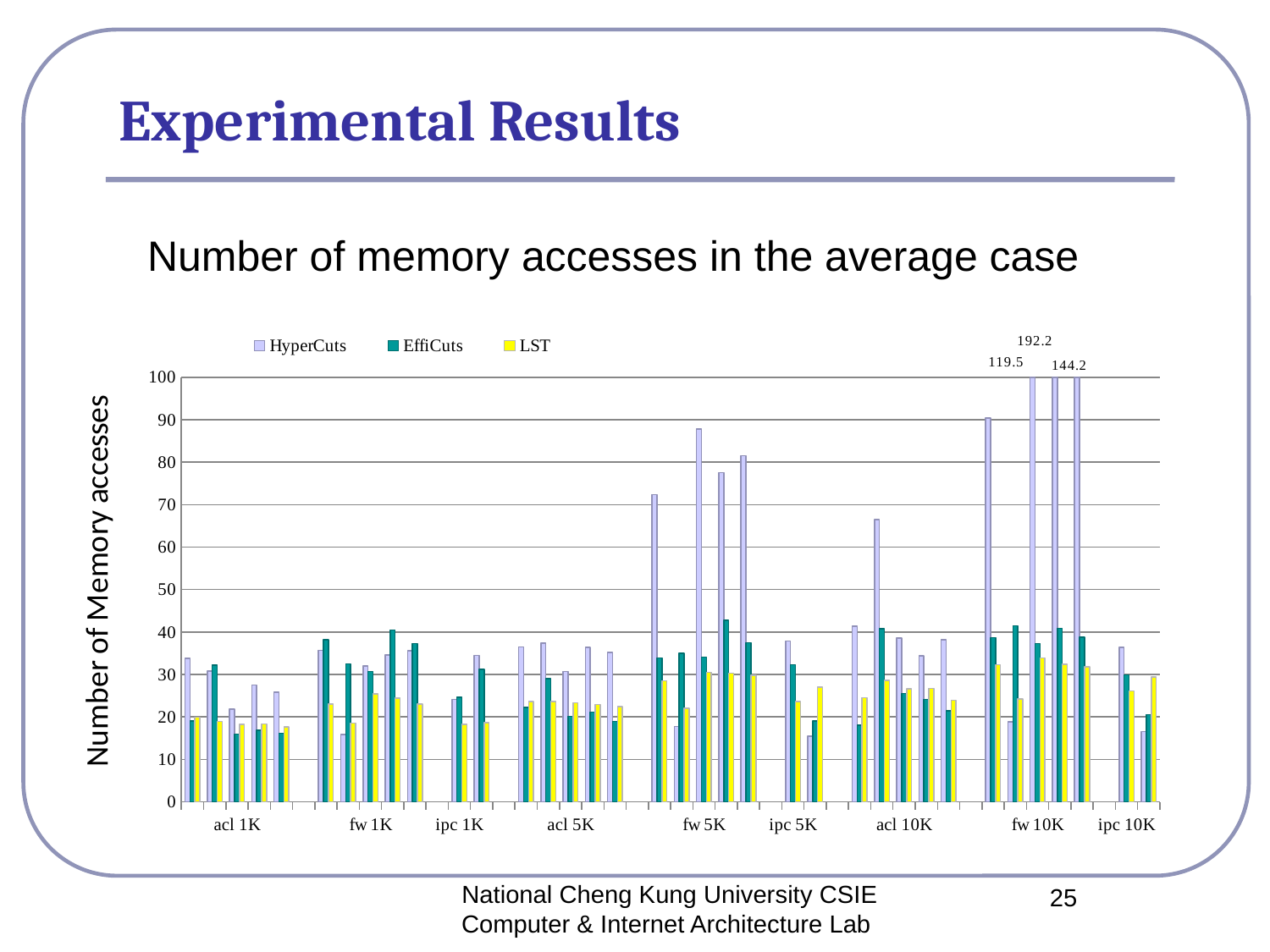
What is the largest value printed as a data label on the chart? 192.2 Which category contains the HyperCuts bars that go above the top of the y axis (100)? fw 10K Which series are listed in the legend? HyperCuts, EffiCuts, LST What is the difference between the data labels 192.2 and 119.5? 72.7 What is the label of the y axis? Number of Memory accesses How many rule-set categories are labelled along the x axis? 9 What are the three data labels printed above the fw 10K HyperCuts bars that exceed the axis? 119.5, 192.2, 144.2 Which is larger among the printed labels, 144.2 or 119.5? 144.2 What kind of chart is shown on the slide? bar chart Is the tallest EffiCuts bar in the fw 5K category greater or less than 50? less How many series does the legend list? 3 Is the tallest HyperCuts bar in the fw 5K category greater or less than 80? greater